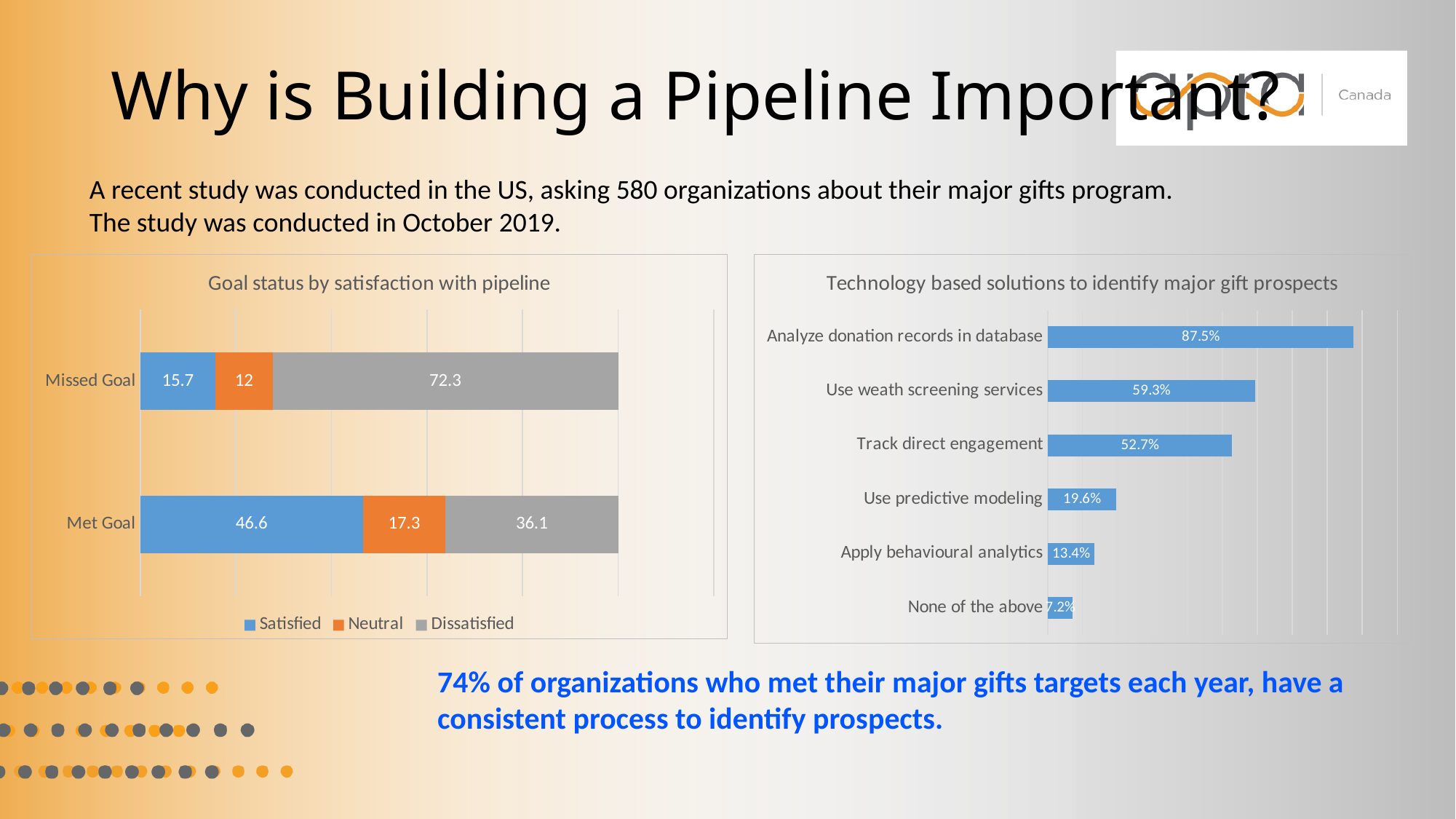
How many series does the legend of the 'Goal status by satisfaction with pipeline' chart list? 3 In the 'Technology based solutions to identify major gift prospects' chart, what is the difference between 'Use weath screening services' and 'Track direct engagement'? 6.6% In the 'Goal status by satisfaction with pipeline' chart, what is the Dissatisfied value for Missed Goal? 72.3 In the 'Goal status by satisfaction with pipeline' chart, what is the Neutral value for Missed Goal? 12 In the 'Technology based solutions to identify major gift prospects' chart, which category has the lowest value? None of the above In the 'Technology based solutions to identify major gift prospects' chart, which category has the highest value? Analyze donation records in database In the 'Goal status by satisfaction with pipeline' chart, what is the difference between the Satisfied values for Met Goal and Missed Goal? 30.9 How many categories are shown in the 'Technology based solutions to identify major gift prospects' chart? 6 In the 'Goal status by satisfaction with pipeline' chart, what is the total of the Met Goal stacked bar? 100 In the 'Goal status by satisfaction with pipeline' chart, what is the Satisfied value for Met Goal? 46.6 In the 'Technology based solutions to identify major gift prospects' chart, what is the value for 'Use predictive modeling'? 19.6% What kind of chart is 'Goal status by satisfaction with pipeline'? Stacked bar chart